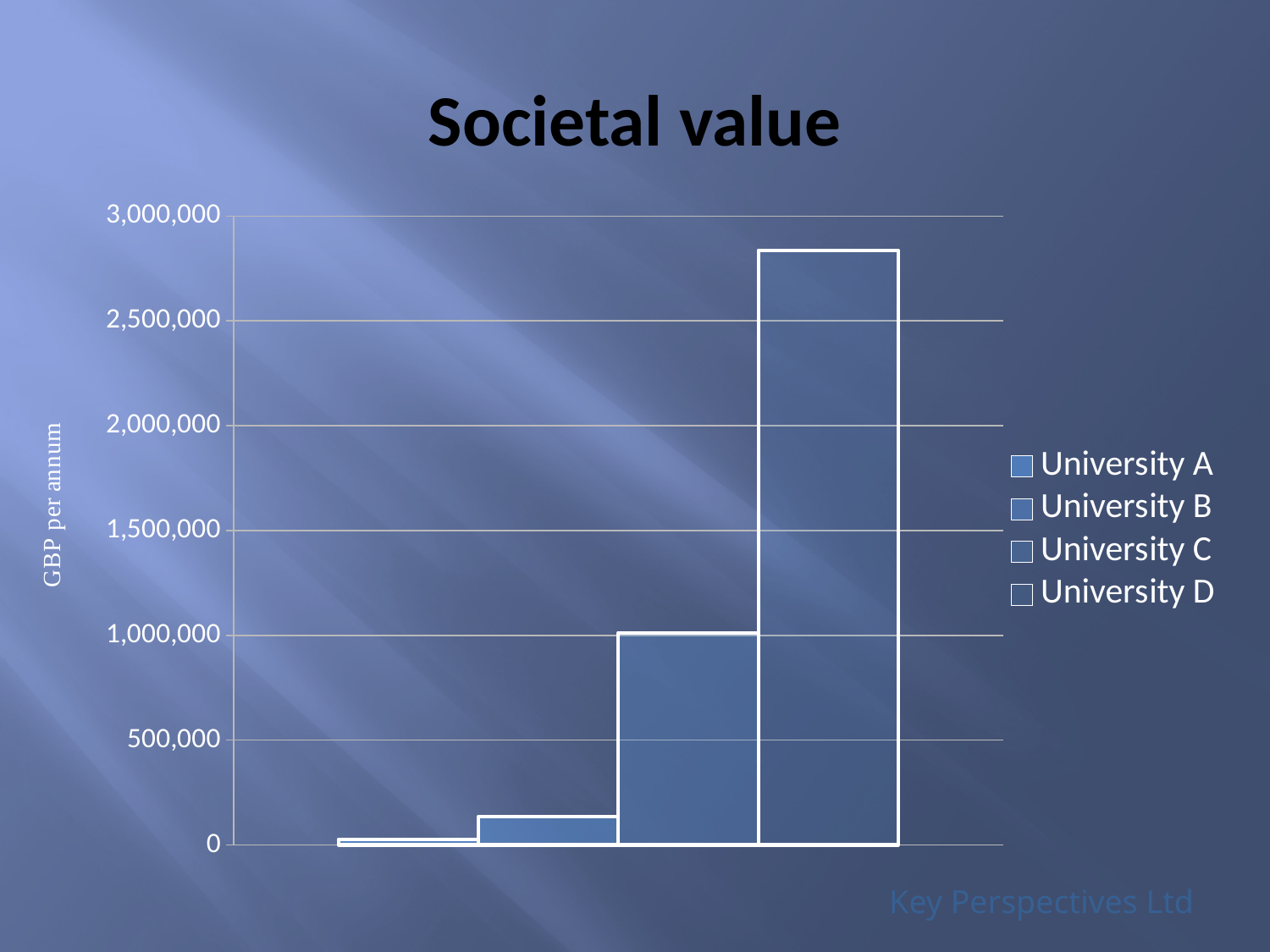
Is the value for University C greater or less than 500,000? greater What is the title of the chart? Societal value Is the value for University D greater or less than 2,500,000? greater Which is larger, the value for University B or University C? University C What kind of chart is shown on the slide? bar chart How many series does the legend list? 4 Is the value for University D greater or less than 3,000,000? less What is the label on the vertical axis? GBP per annum Which university has the lowest societal value? University A Which is larger, the value for University C or University D? University D Which university has the highest societal value? University D